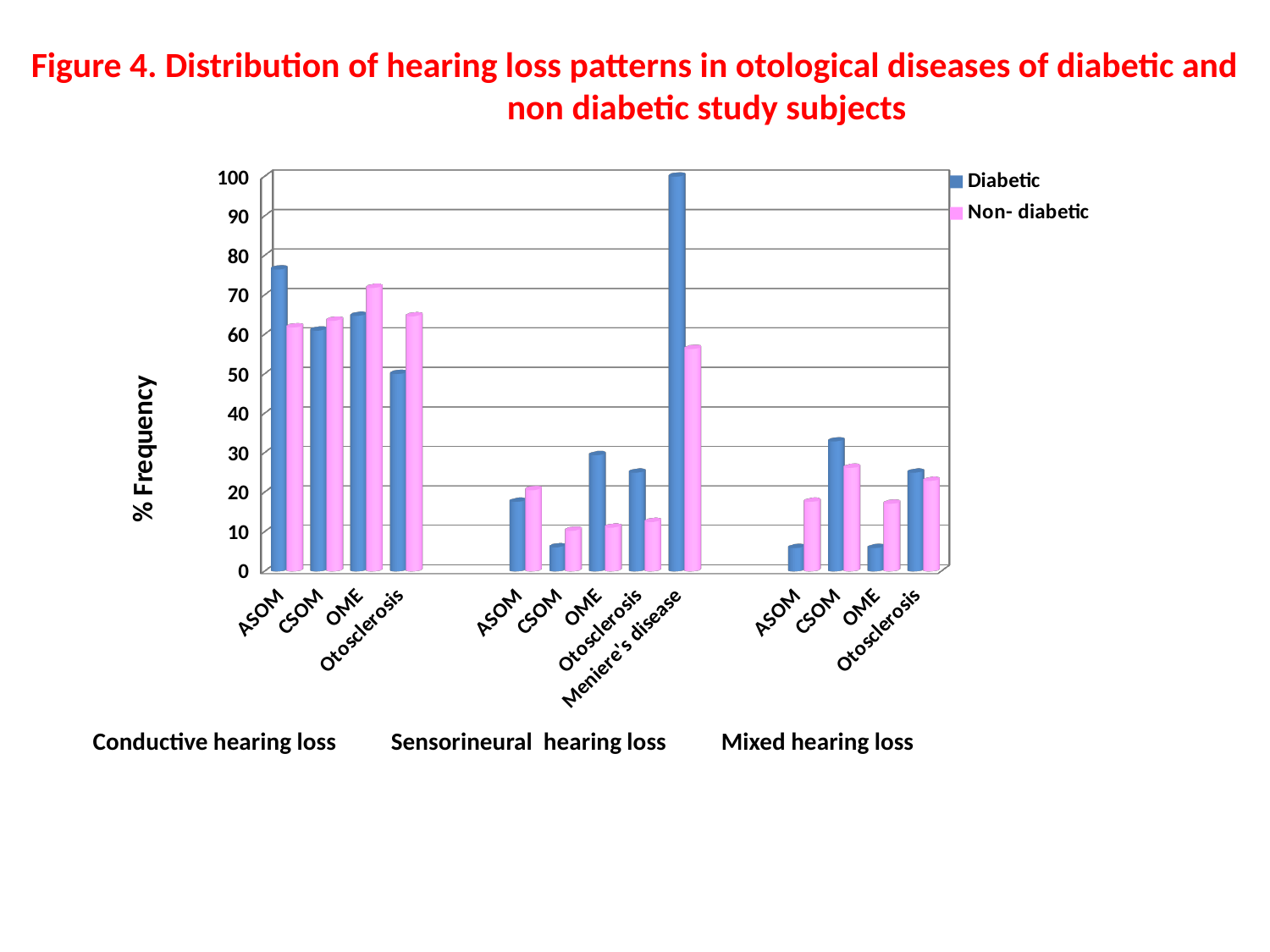
For ASOM under mixed hearing loss, which series has the larger value, Diabetic or Non- diabetic? Non- diabetic How many series does the legend list? 2 What is the Diabetic value for Meniere's disease under sensorineural hearing loss? 100 For ASOM under conductive hearing loss, which series has the larger value, Diabetic or Non- diabetic? Diabetic How many disease categories are shown along the x axis in total? 13 Is the Diabetic value for CSOM under sensorineural hearing loss greater or less than 10? less Is the Non- diabetic value for Meniere's disease under sensorineural hearing loss greater or less than 50? greater Is the Diabetic value for ASOM under conductive hearing loss greater or less than 70? greater What are the two series named in the legend? Diabetic and Non- diabetic Which category and series has the highest bar in the chart? Meniere's disease, Diabetic What kind of chart is shown on the slide? bar chart What is the label on the vertical axis? % Frequency